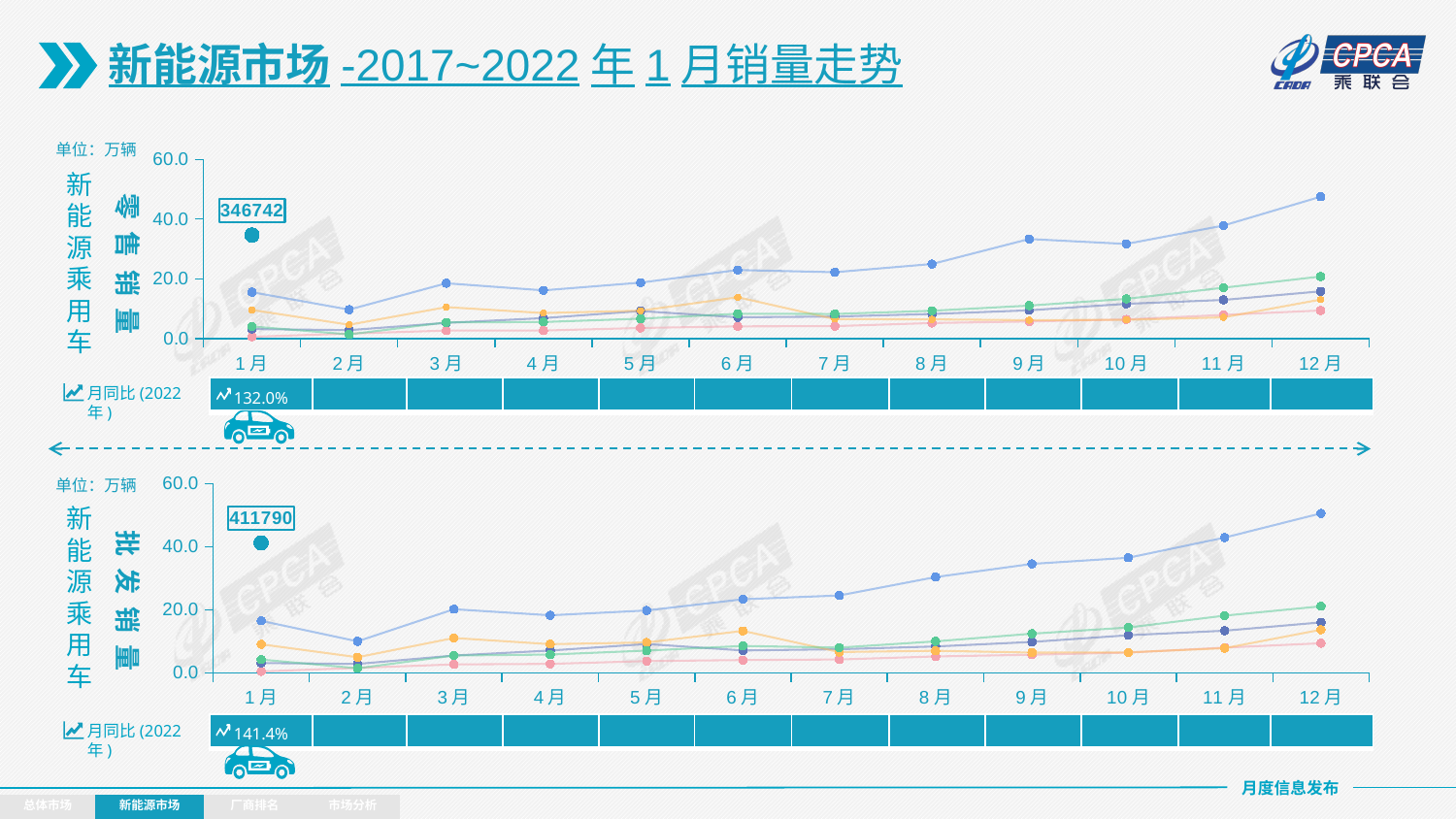
On the top chart (零售销量), what value is printed on the data label for the January point? 346742 On the top chart (零售销量), is the labeled January point (346742) greater or less than 20? greater What unit is stated for the values on both charts? 万辆 On the bottom chart (批发销量), is the highest December point greater or less than 40? greater What kind of chart is the top chart (新能源乘用车零售销量)? line chart On the top chart (零售销量), is the highest December point greater or less than 40? greater How many months are shown on the x axis of the bottom chart (新能源乘用车批发销量)? 12 On the top chart (零售销量), in which month does the highest line reach its highest point? 12月 On the bottom chart (批发销量), which is larger: the highest December point or the labeled January point? the December point On the bottom chart (批发销量), does the topmost line generally rise or fall from 1月 to 12月? rise On the bottom chart (批发销量), what value is printed on the data label for the January point? 411790 What 月同比 (2022年) percentage is shown below the top chart (零售销量)? 132.0%